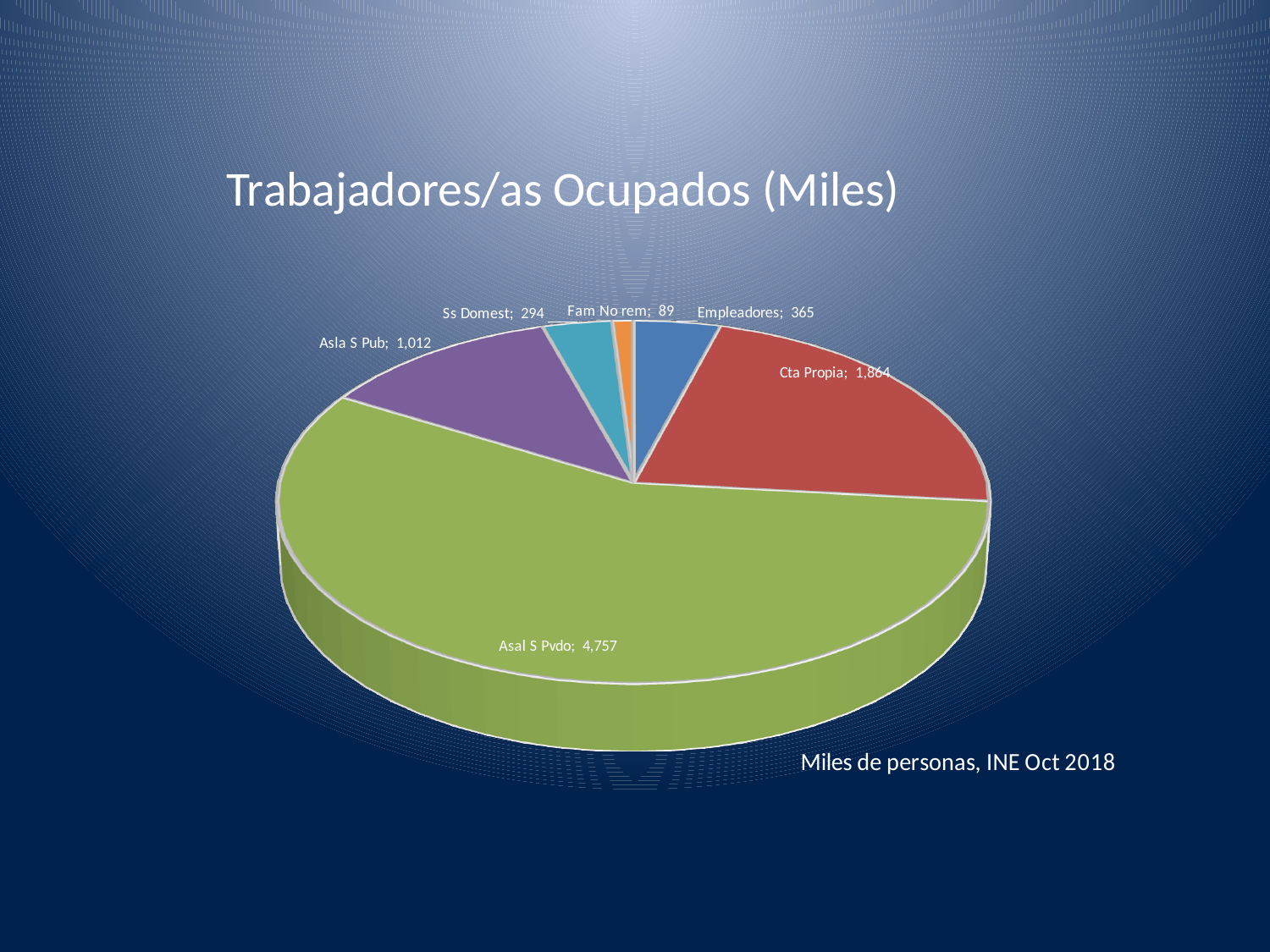
What is the total of all slices in the pie chart? 8,381 What is the value for Fam No rem? 89 What is the value for Asla S Pub? 1,012 How many slices does the pie chart have? 6 What is the title of the chart? Trabajadores/as Ocupados (Miles) Which is larger, Empleadores or Ss Domest? Empleadores What is the value for Asal S Pvdo? 4,757 Which category has the largest slice? Asal S Pvdo What type of chart is shown on the slide? Pie chart Which category has the smallest slice? Fam No rem What is the value for Cta Propia? 1,864 What is the difference between the values for Cta Propia and Asla S Pub? 852